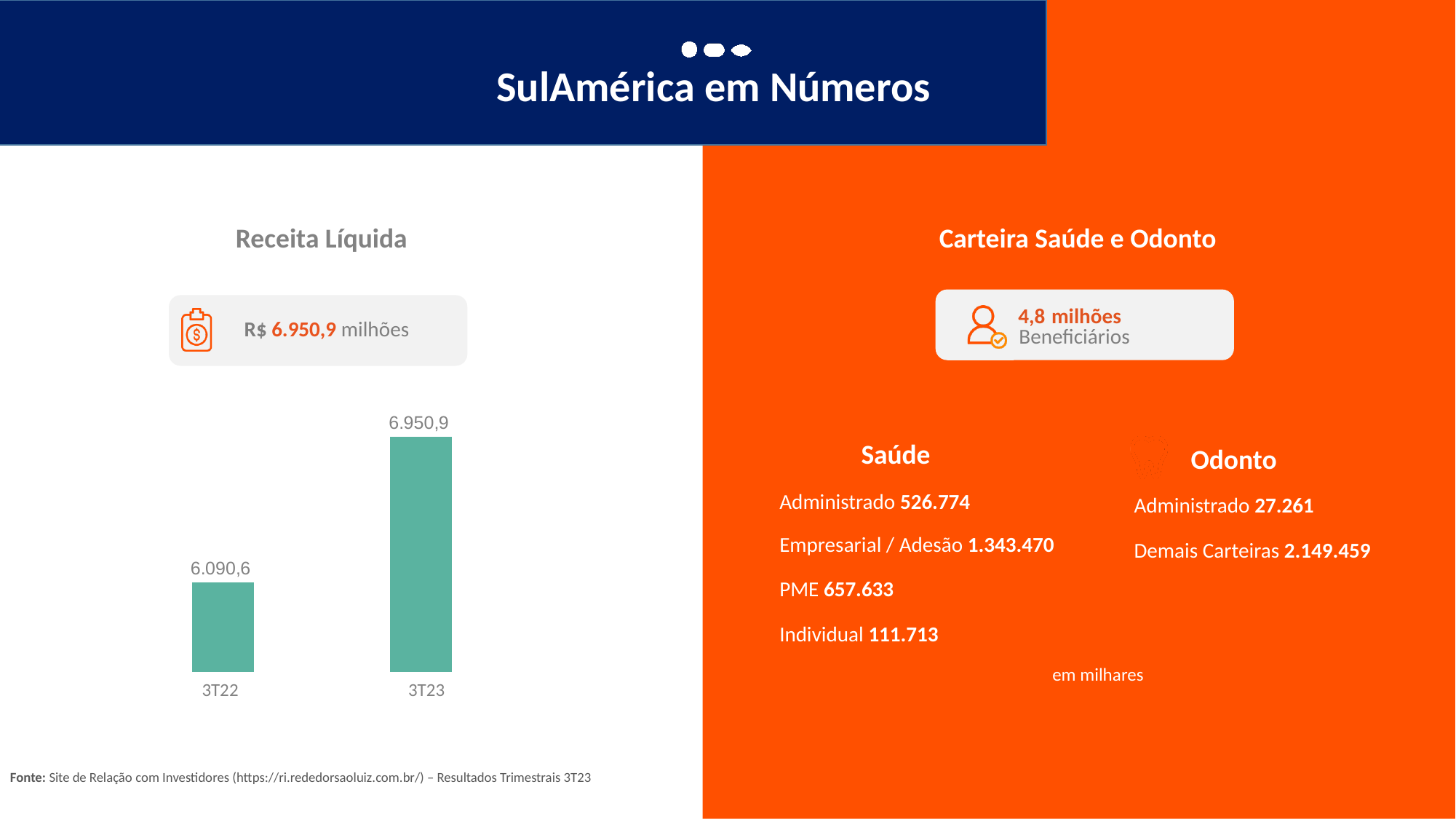
Do the values in the Receita Líquida chart rise or fall from 3T22 to 3T23? Rise What is the value for 3T22 in the Receita Líquida chart? 6.090,6 In the Receita Líquida chart, which is larger: the value for 3T22 or the value for 3T23? 3T23 What is the difference between the 3T23 and 3T22 values in the Receita Líquida chart? 860,3 Which period has the lowest value in the Receita Líquida chart? 3T22 What is the title of the chart on the left side of the slide? Receita Líquida How many bars are plotted in the Receita Líquida chart? 2 What colour are the bars in the Receita Líquida chart? Teal green What is the value for 3T23 in the Receita Líquida chart? 6.950,9 What kind of chart is the Receita Líquida chart? Bar chart Which period has the highest value in the Receita Líquida chart? 3T23